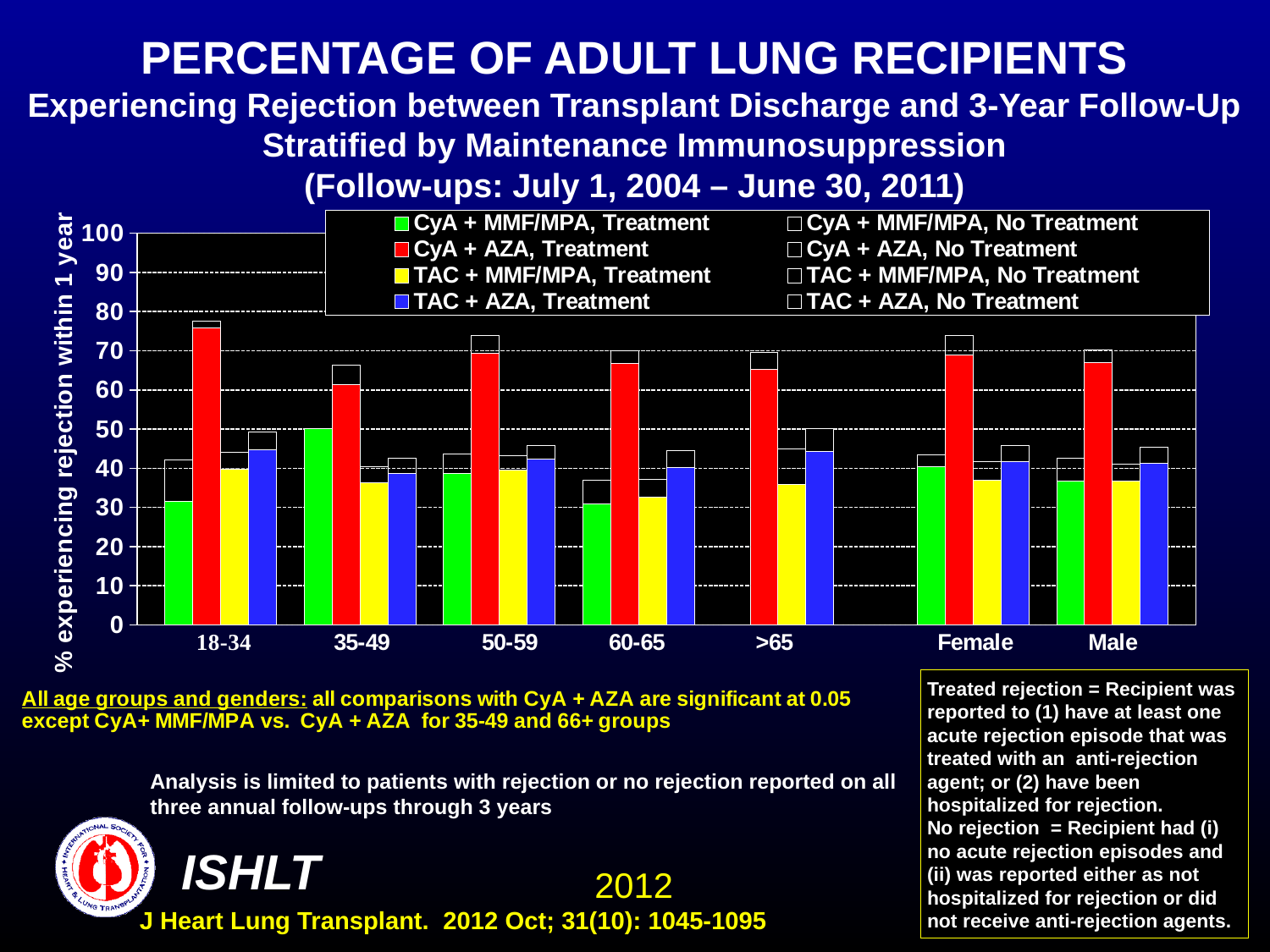
Is the value for CyA + MMF/MPA, Treatment in the 35-49 group greater or less than 40? greater How many categories are shown along the x axis of the chart? 7 Which category has the highest CyA + AZA, Treatment bar? 18-34 In the 18-34 group, which is larger: the CyA + AZA, Treatment bar or the TAC + AZA, Treatment bar? CyA + AZA, Treatment What is the label of the chart's y axis? % experiencing rejection within 1 year What kind of chart is shown on the slide? bar chart Is the value for CyA + AZA, Treatment in the 35-49 group greater or less than 70? less Is the value for CyA + AZA, Treatment in the 18-34 group greater or less than 70? greater What is the highest value shown on the chart's y axis? 100 In the 35-49 group, which is larger: the CyA + MMF/MPA, Treatment bar or the TAC + MMF/MPA, Treatment bar? CyA + MMF/MPA, Treatment How many series does the chart's legend list? 8